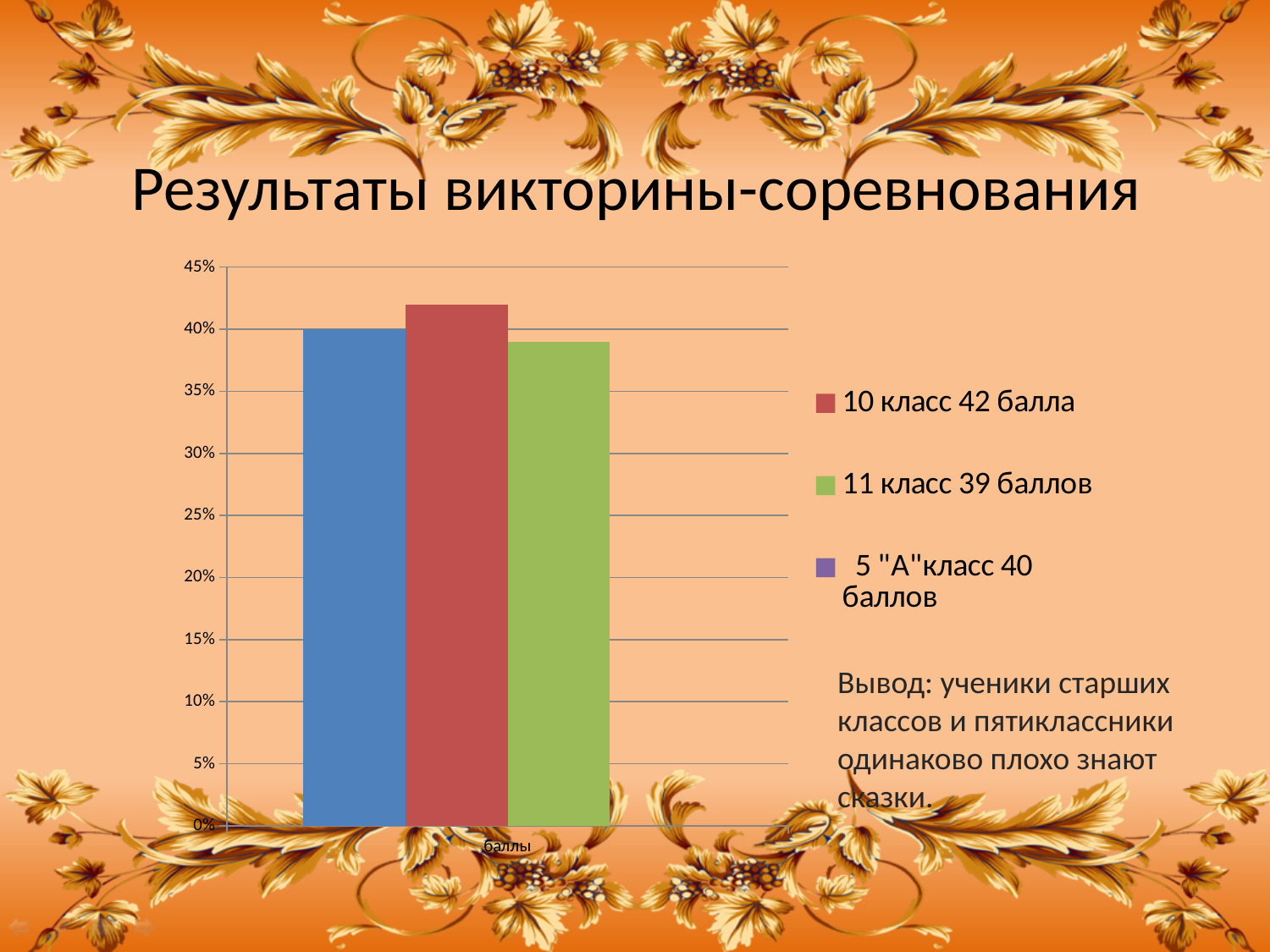
What label is shown on the horizontal axis of the chart? баллы Is the value of the red bar (10 класс) greater or less than 40%? greater Which series has the tallest bar in the chart? 10 класс 42 балла What kind of chart is shown on the slide? bar chart According to the legend, how many points did 10 класс score? 42 балла Which bar is taller, the red bar (10 класс) or the green bar (11 класс)? the red bar (10 класс) Is the value of the blue bar greater or less than 35%? greater Is the value of the green bar (11 класс) greater or less than 40%? less Which series has the shortest bar in the chart? 11 класс 39 баллов What is the title of the slide above the chart? Результаты викторины-соревнования How many series does the chart legend list? 3 How many bars are plotted in the chart? 3